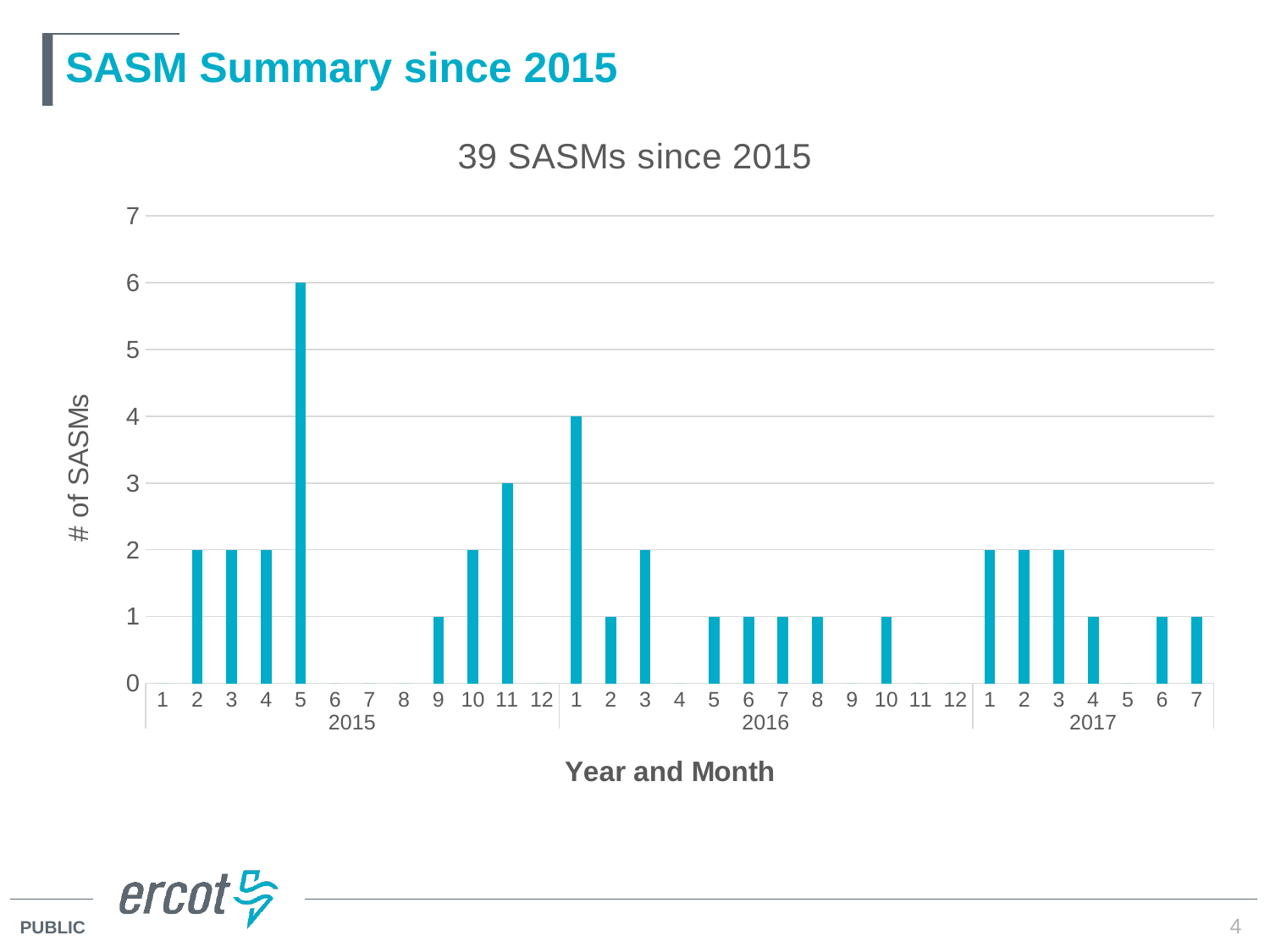
How many SASMs were there in month 1 of 2016? 4 What kind of chart is shown on the slide? bar chart How many SASMs were there in month 4 of 2017? 1 How many months are shown on the x axis of the chart? 31 How many SASMs were there in month 11 of 2015? 3 Which month has the highest number of SASMs? Month 5 of 2015 What is the label of the y axis? # of SASMs What is the difference between the number of SASMs in month 5 of 2015 and month 1 of 2016? 2 Is the number of SASMs in month 5 of 2015 greater or less than 5? greater How many SASMs were there in month 5 of 2015? 6 Which is larger: the number of SASMs in month 11 of 2015 or in month 3 of 2016? Month 11 of 2015 What is the chart's title? 39 SASMs since 2015